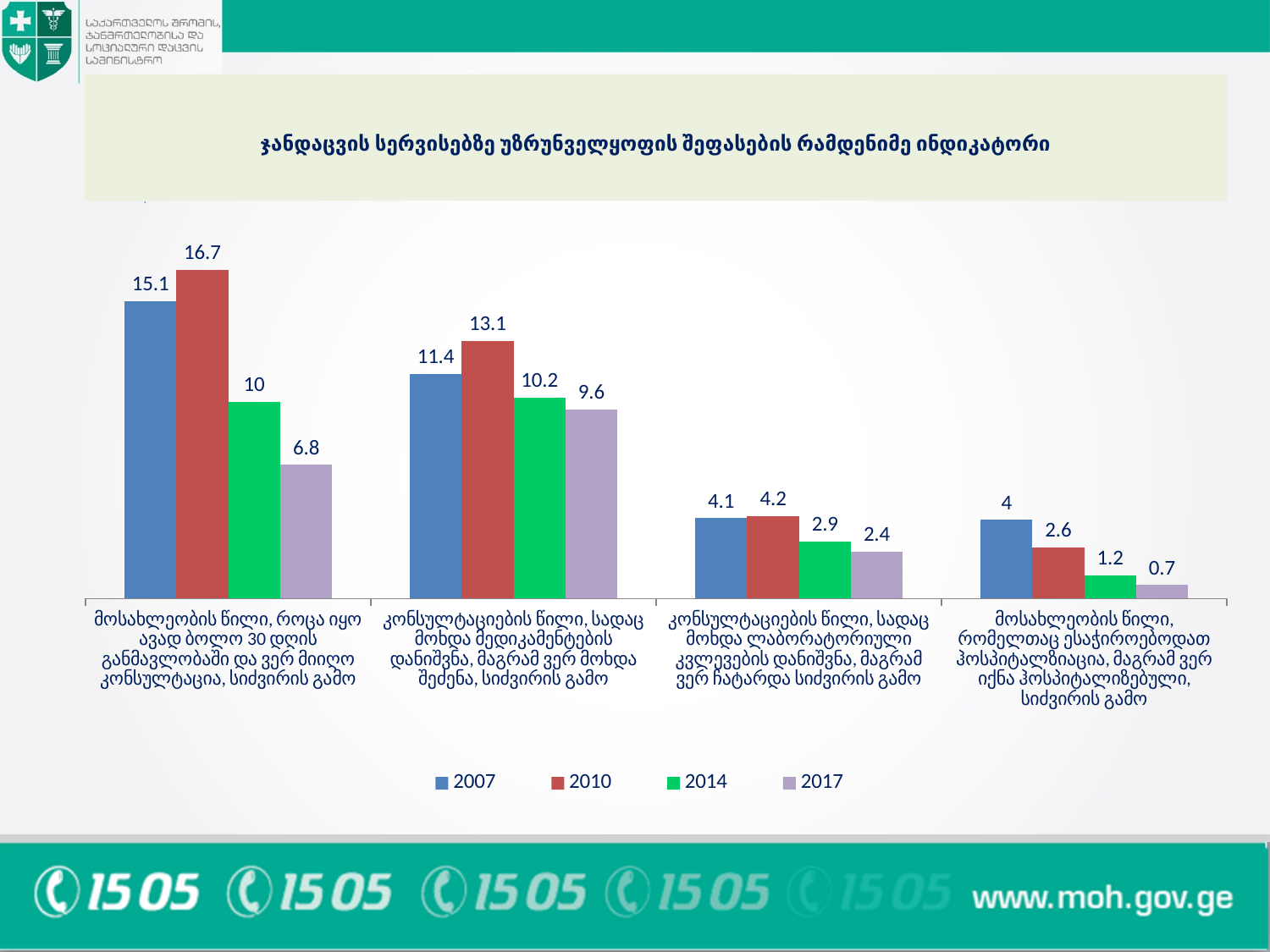
What is the value for 2007 in the rightmost category group? 4 What type of chart is shown on the slide? bar chart Which year has the highest value in the leftmost category group? 2010 Which year has the lowest value in the rightmost category group? 2017 What is the value for 2014 in the third category group from the left? 2.9 In the second category group from the left, which is larger: the 2014 value or the 2017 value? 2014 What is the value for 2010 in the leftmost category group? 16.7 What is the value for 2017 in the second category group from the left? 9.6 How many category groups are shown along the x axis? 4 In the rightmost category group, do the values rise or fall from 2007 to 2017? fall What is the difference between the 2007 and 2017 values in the leftmost category group? 8.3 How many series does the legend list? 4